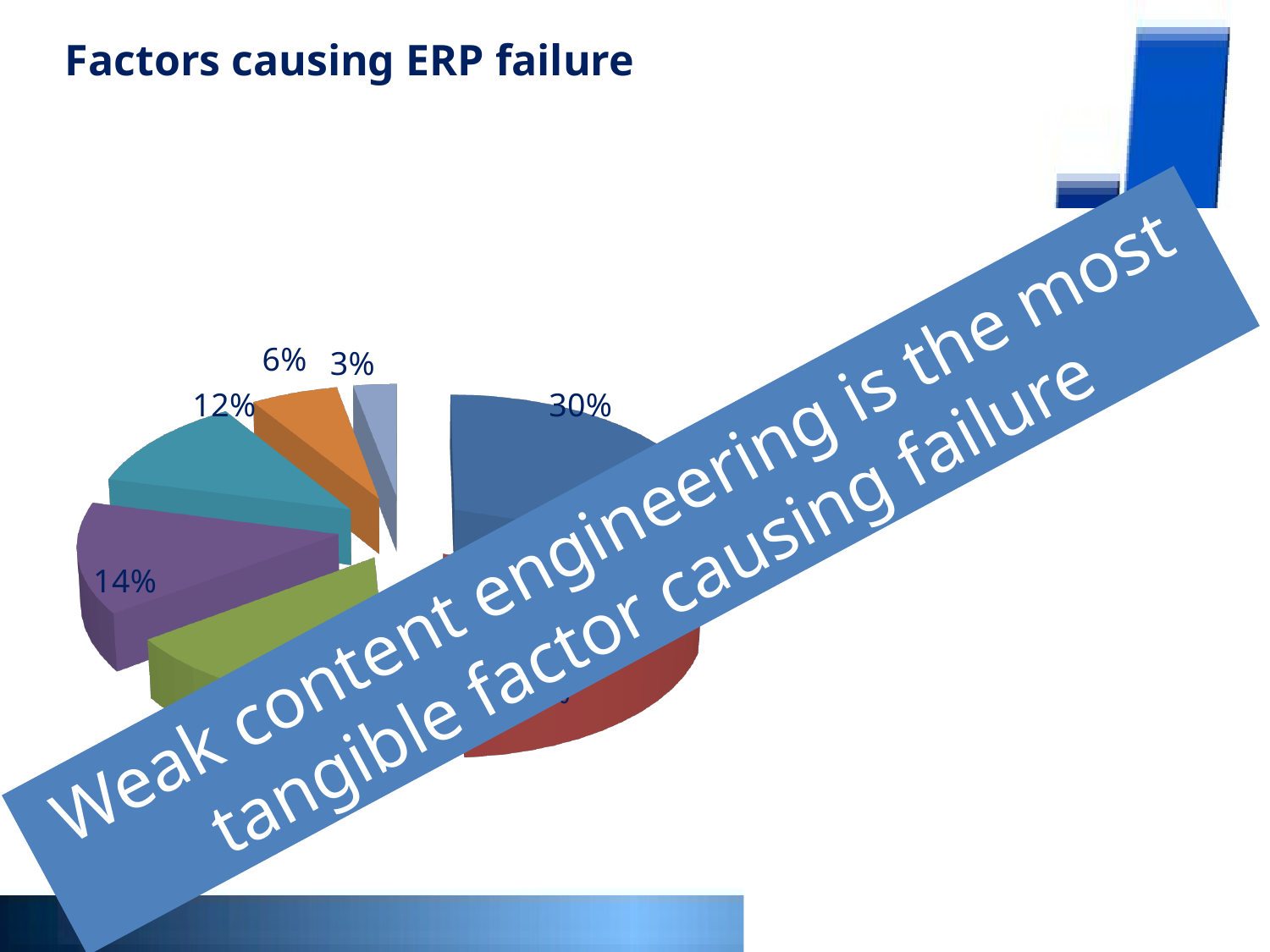
What colour is the slice labelled 30%? dark blue Which is larger, the purple slice or the teal slice? purple slice What percentage is labelled on the dark blue slice of the pie chart? 30% What kind of chart is shown on the slide? pie chart What percentage is labelled on the light blue slice of the pie chart? 3% What is the difference between the dark blue slice (30%) and the light blue slice (3%)? 27% What percentage is labelled on the teal slice of the pie chart? 12% Which labelled slice of the pie chart has the smallest share? 3% What is the difference between the purple slice (14%) and the teal slice (12%)? 2% What is the title of the chart on the slide? Factors causing ERP failure What percentage is labelled on the purple slice of the pie chart? 14% What percentage is labelled on the orange slice of the pie chart? 6%